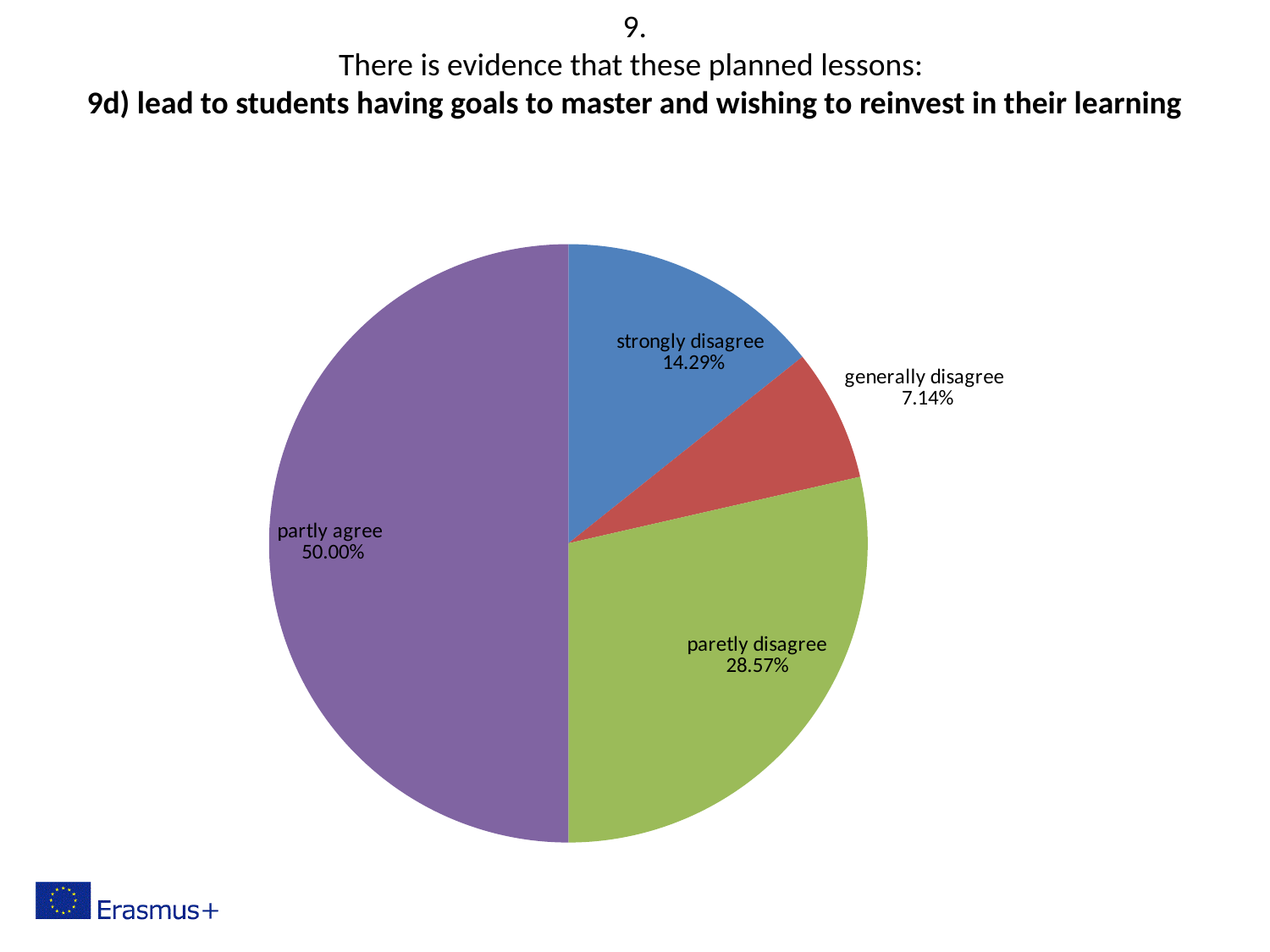
Which category has the largest slice of the pie? partly agree Which is larger, the "strongly disagree" slice or the "paretly disagree" slice? paretly disagree Which category has the smallest slice of the pie? generally disagree How many categories are shown in the pie chart? 4 What is the difference between the "strongly disagree" and "generally disagree" values? 7.15% What kind of chart is shown on the slide? pie chart What is the value shown for "strongly disagree"? 14.29% What is the difference between the "partly agree" and "paretly disagree" values? 21.43% What is the value shown for "paretly disagree"? 28.57% What colour is the "partly agree" slice? purple What share of the pie is labelled "partly agree"? 50.00% What is the value shown for "generally disagree"? 7.14%